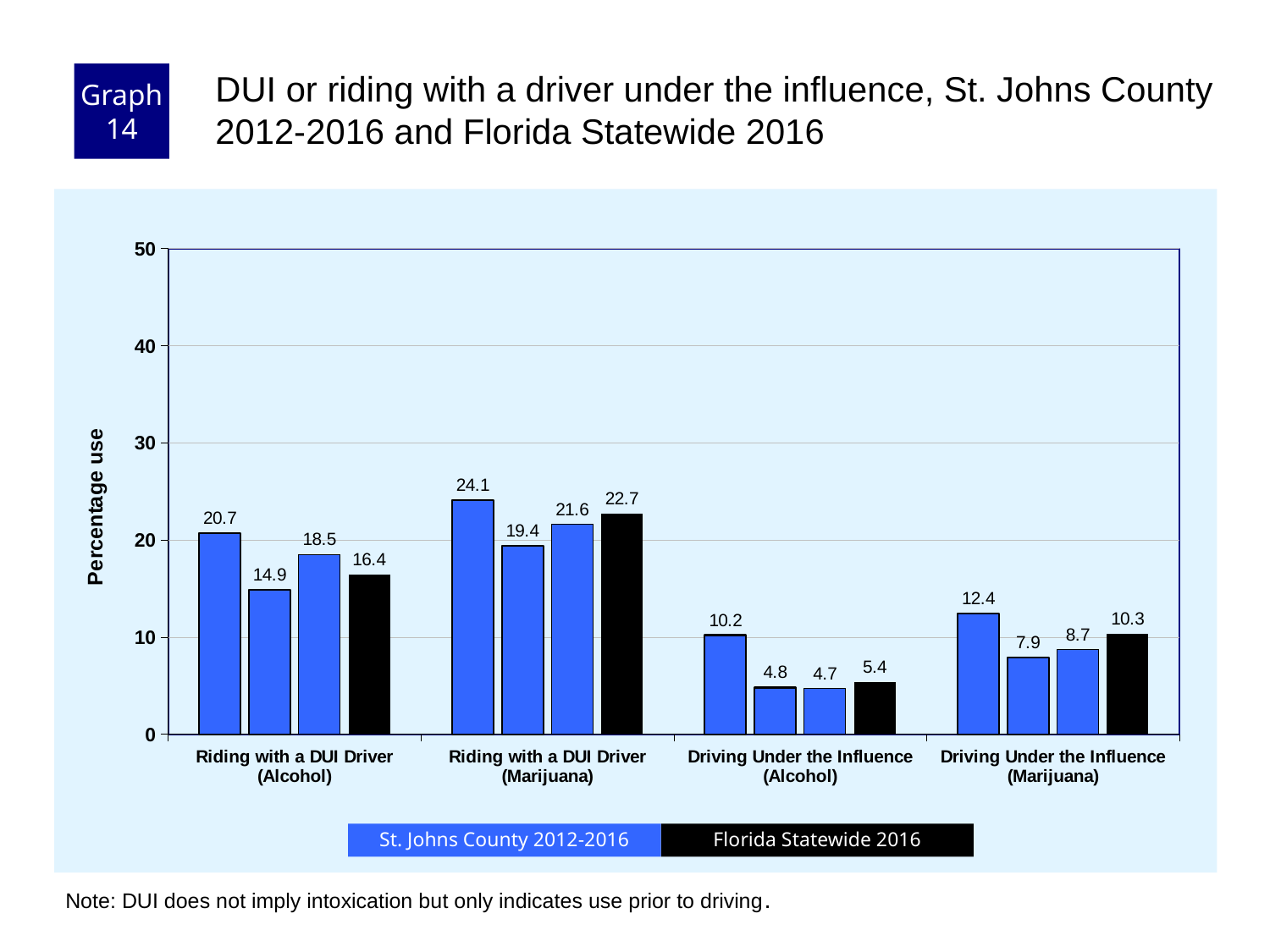
What is the Florida Statewide 2016 value for Riding with a DUI Driver (Alcohol)? 16.4 How many entries does the legend list? 2 Which is larger: the Florida Statewide 2016 value for Driving Under the Influence (Marijuana) or for Driving Under the Influence (Alcohol)? Driving Under the Influence (Marijuana) What is the Florida Statewide 2016 value for Riding with a DUI Driver (Marijuana)? 22.7 Is the Florida Statewide 2016 value for Riding with a DUI Driver (Marijuana) greater or less than 20? greater What is the Florida Statewide 2016 value for Driving Under the Influence (Marijuana)? 10.3 What kind of chart is shown on the slide? Bar chart Which category has the lowest Florida Statewide 2016 value? Driving Under the Influence (Alcohol) What is the value of the tallest bar in the Driving Under the Influence (Alcohol) group? 10.2 What is the difference between the Florida Statewide 2016 values for Riding with a DUI Driver (Marijuana) and Riding with a DUI Driver (Alcohol)? 6.3 Which category has the highest Florida Statewide 2016 value? Riding with a DUI Driver (Marijuana) How many categories are shown on the x axis? 4